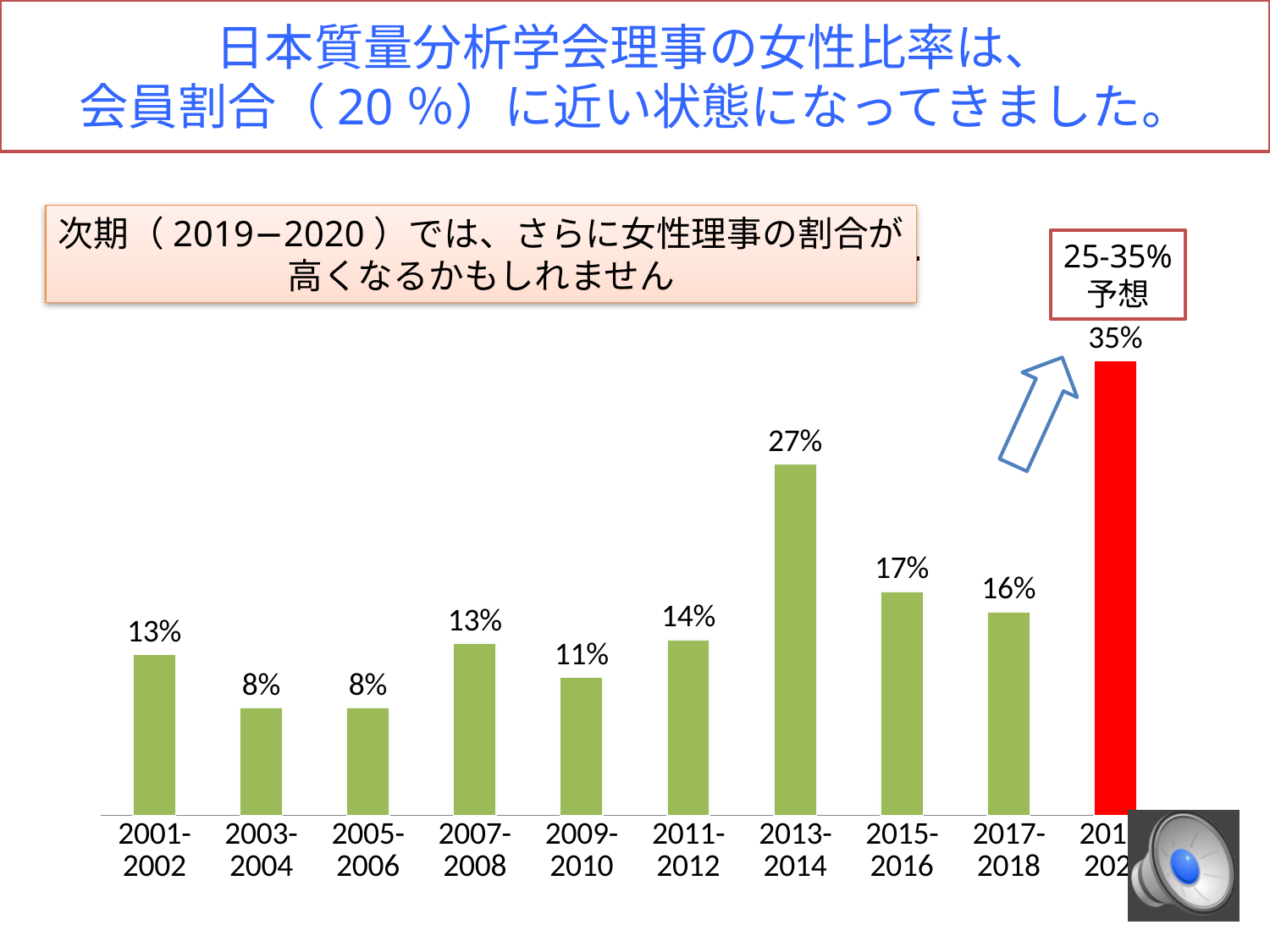
Which is larger, the value for 2009-2010 or the value for 2011-2012? 2011-2012 What value is printed above the red bar? 35% Which periods have the lowest value? 2003-2004 and 2005-2006 What is the value for 2013-2014? 27% Among the green bars (2001-2002 through 2017-2018), which period has the highest value? 2013-2014 Do the values rise or fall from 2013-2014 to 2017-2018? fall How many bars are plotted in the chart? 10 What is the difference between the values for 2013-2014 and 2015-2016? 10% What is the value for 2003-2004? 8% What is the value for 2017-2018? 16% What kind of chart is shown on the slide? bar chart What is the value for 2001-2002? 13%